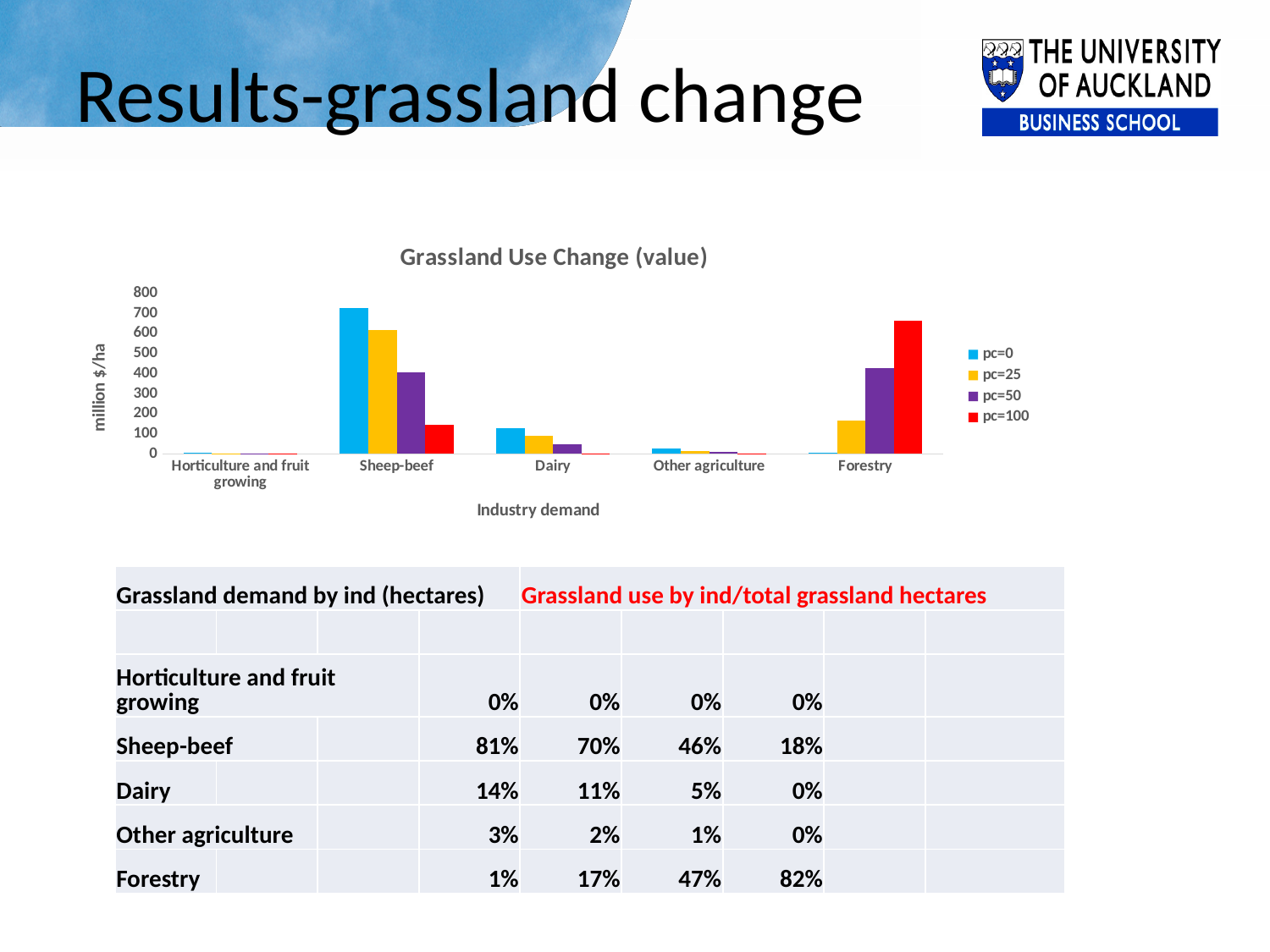
Which is larger: the pc=100 value for Sheep-beef or the pc=100 value for Forestry? Forestry Which industry has the highest pc=100 value in the chart? Forestry Which industry has the highest pc=0 value in the chart? Sheep-beef What is the label on the y axis of the chart? million $/ha Is the pc=0 value for Sheep-beef greater or less than 700? greater Is the pc=25 value for Forestry greater or less than 200? less How many industry categories are shown on the x axis of the chart? 5 How many series does the legend of the chart list? 4 Is the pc=100 value for Forestry greater or less than 600? greater What kind of chart is shown on the slide? bar chart Which is larger: the pc=0 value for Dairy or the pc=0 value for Other agriculture? Dairy